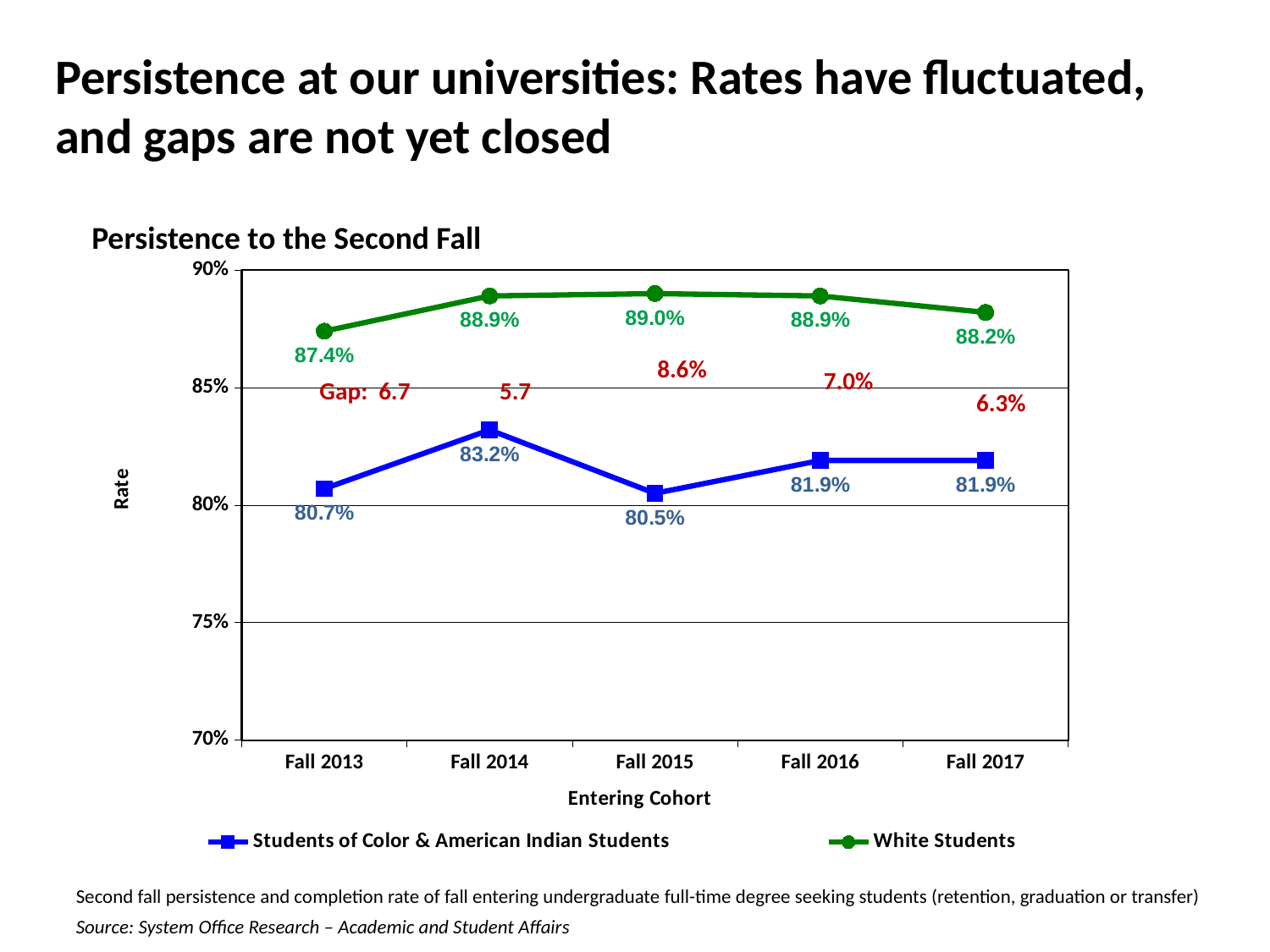
What is the title of the chart? Persistence to the Second Fall Which entering cohort has the lowest persistence rate for White Students? Fall 2013 What is the persistence rate for White Students in the Fall 2013 cohort? 87.4% What is the persistence rate for Students of Color & American Indian Students in the Fall 2015 cohort? 80.5% Which series has the higher persistence rate for the Fall 2016 cohort? White Students How many series does the legend list? 2 What is the difference between the White Students rate and the Students of Color & American Indian Students rate for the Fall 2014 cohort? 5.7 What kind of chart is shown on the slide? Line chart What is the persistence rate for White Students in the Fall 2017 cohort? 88.2% How many entering cohorts are shown on the x axis? 5 Which entering cohort has the highest persistence rate for Students of Color & American Indian Students? Fall 2014 Is the Students of Color & American Indian Students rate for Fall 2014 greater or less than 85%? less